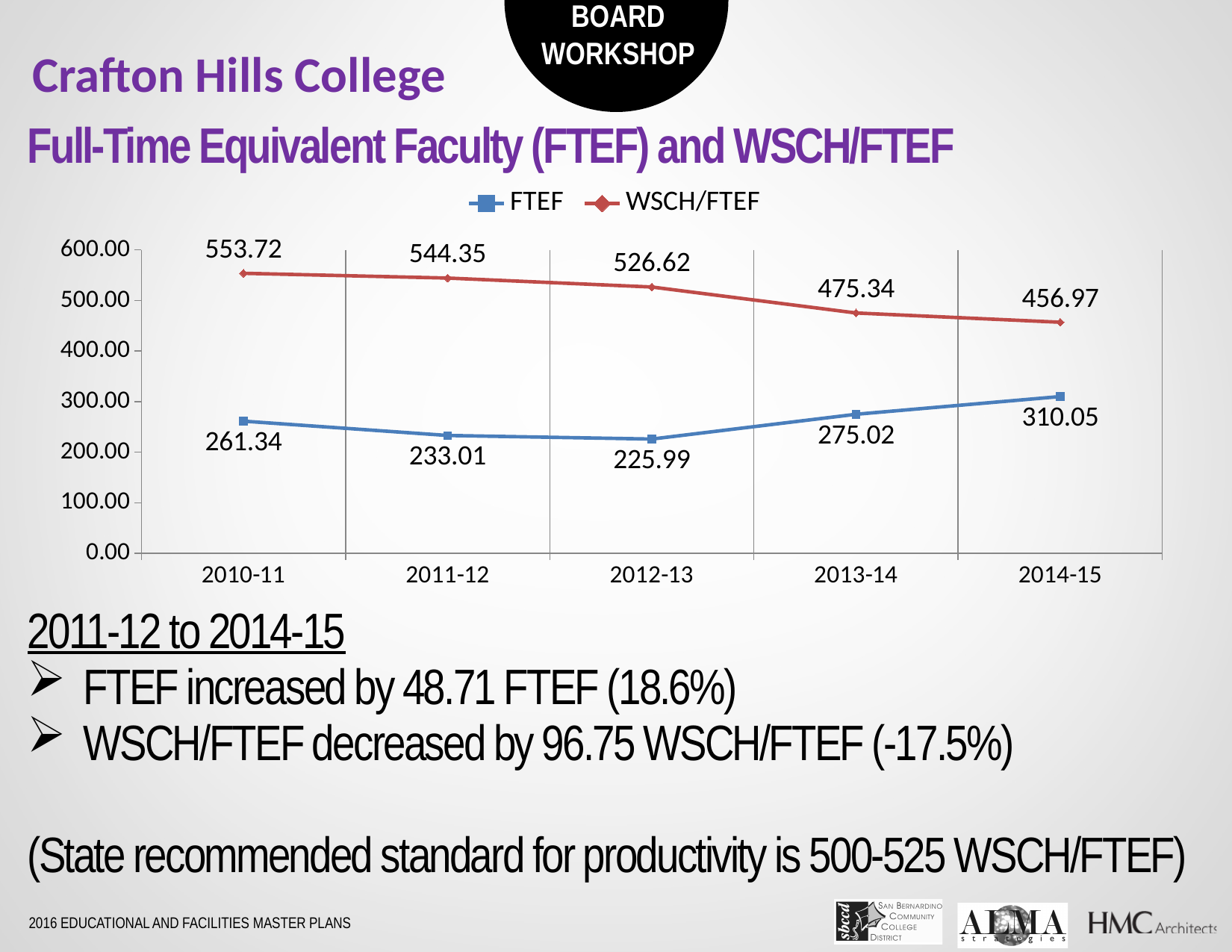
Which is larger, FTEF in 2010-11 or FTEF in 2013-14? FTEF in 2013-14 In which year is FTEF lowest? 2012-13 What kind of chart is shown? Line chart What is the WSCH/FTEF value for 2013-14? 475.34 How many series does the legend list? 2 Does WSCH/FTEF rise or fall from 2010-11 to 2014-15? Fall What is the FTEF value for 2012-13? 225.99 What is the FTEF value for 2014-15? 310.05 How many years are shown on the x axis? 5 By how much did WSCH/FTEF fall from 2010-11 to 2014-15? 96.75 In which year is WSCH/FTEF highest? 2010-11 What is the difference between WSCH/FTEF and FTEF in 2014-15? 146.92